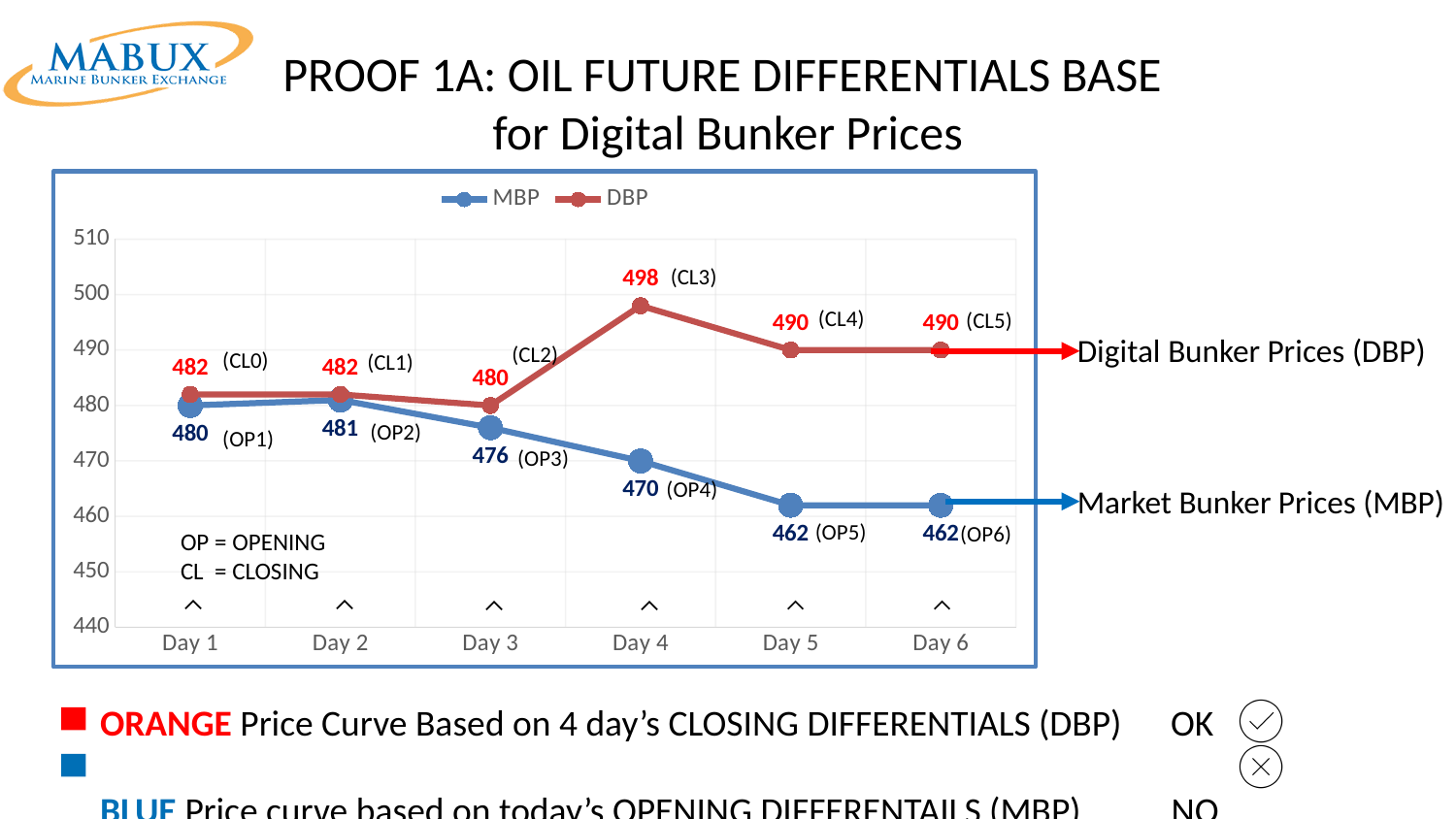
How many series does the legend list? 2 On Day 5, which series has the larger value, MBP or DBP? DBP How many days are shown on the x axis? 6 Does the MBP series rise or fall from Day 2 to Day 5? fall What is the DBP value on Day 4? 498 What is the MBP value on Day 6? 462 Is the MBP value on Day 4 greater or less than 480? less What kind of chart is shown on the slide? line chart What is the MBP value on Day 3? 476 On which day is the DBP series at its highest? Day 4 What is the difference between the DBP and MBP values on Day 4? 28 What is the lowest value plotted for the MBP series? 462